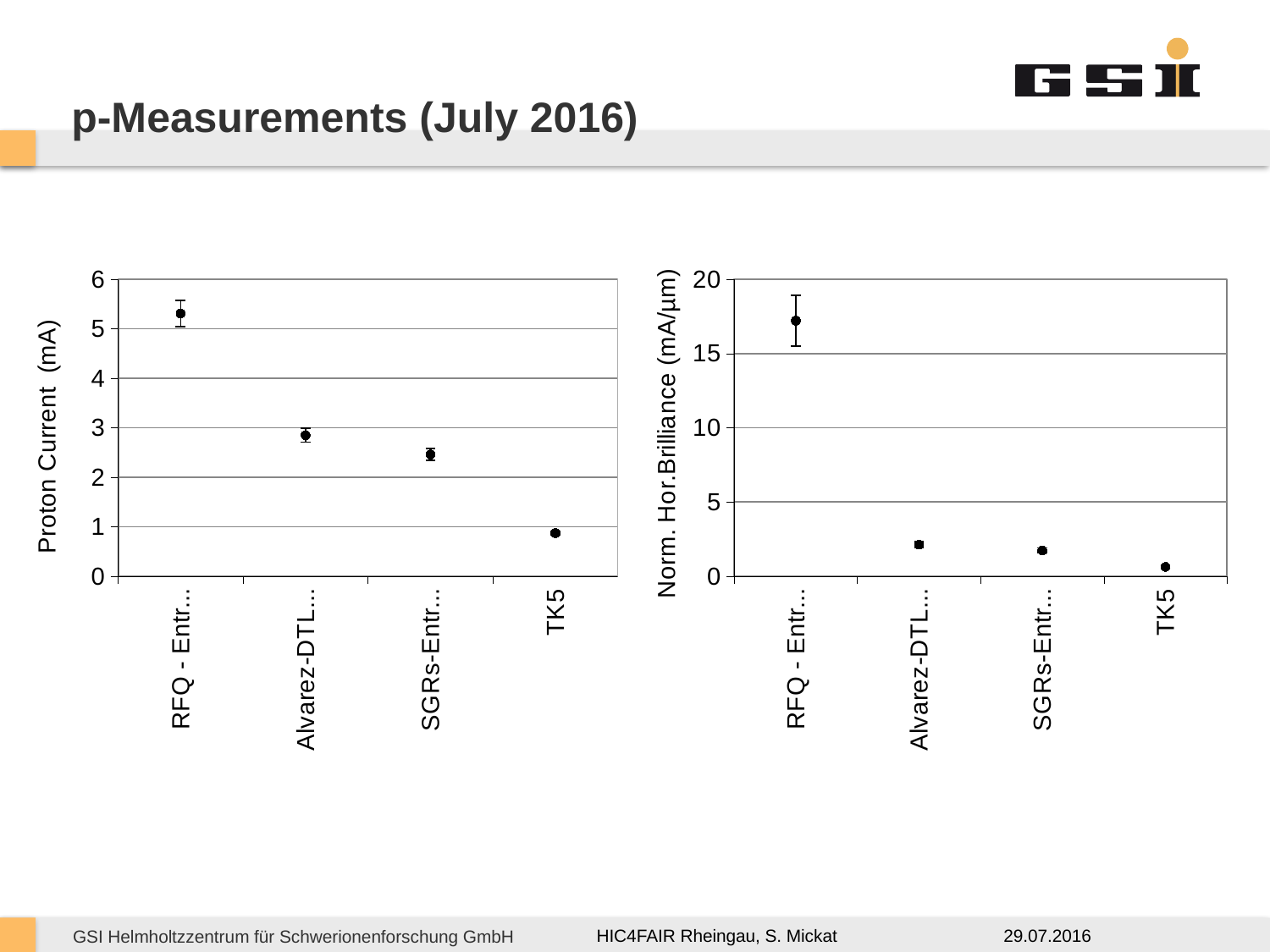
In the left chart (Proton Current), is the value for Alvarez-DTL... greater or less than 3? less In the left chart (Proton Current), how many categories are plotted on the x axis? 4 What is the y-axis label of the right chart? Norm. Hor.Brilliance (mA/µm) In the left chart (Proton Current), which category has the lowest value? TK5 In the left chart (Proton Current), is the value for RFQ - Entr... greater or less than 5? greater In the right chart (Norm. Hor. Brilliance), is the value for RFQ - Entr... greater or less than 15? greater In the right chart (Norm. Hor. Brilliance), which category has the lowest value? TK5 In the right chart (Norm. Hor. Brilliance), which category has the highest value? RFQ - Entr... In the left chart (Proton Current), do the values rise or fall from left to right along the x axis? fall In the left chart (Proton Current), which category has the highest value? RFQ - Entr...